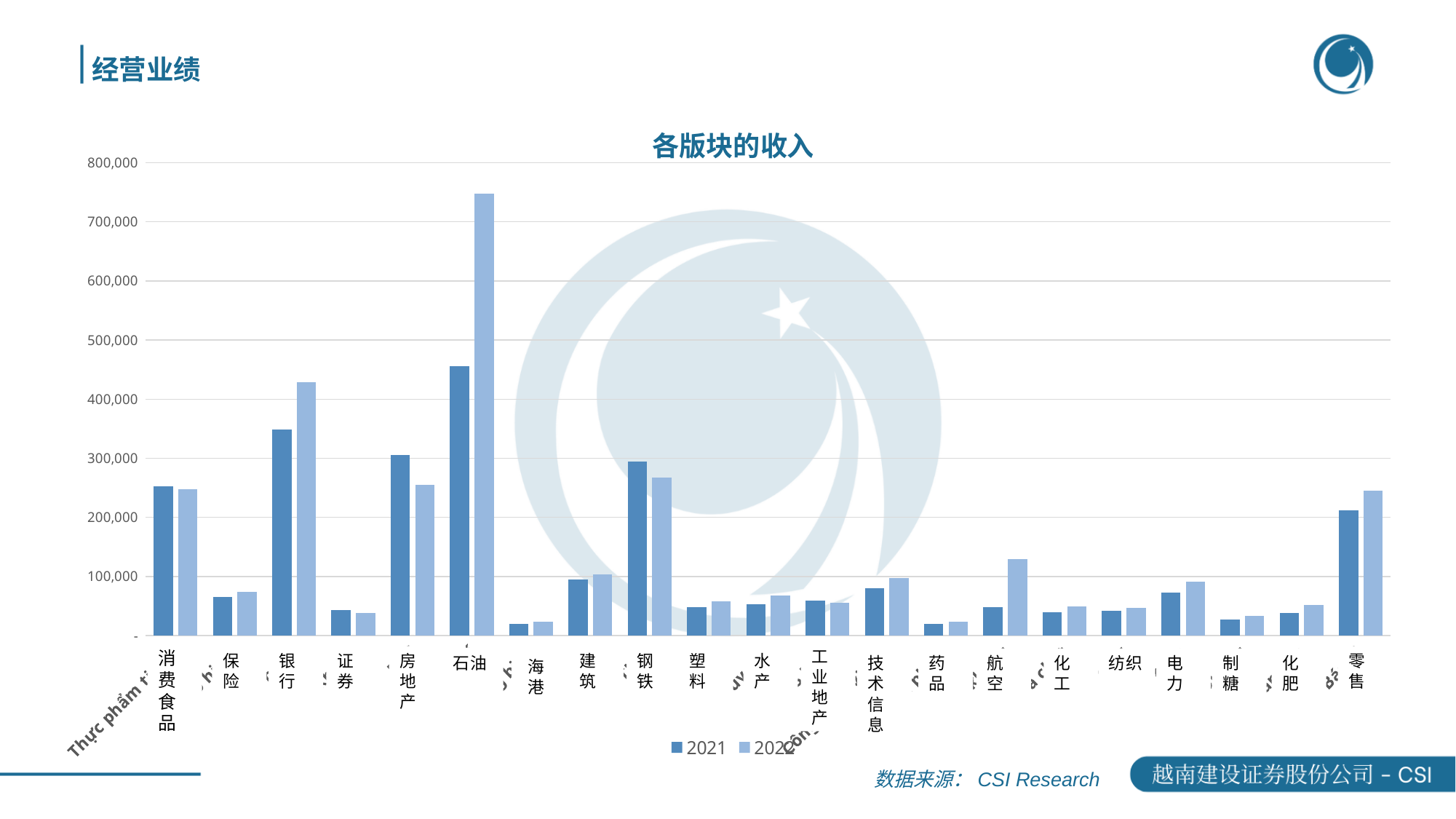
Which sector has the highest bar in the chart? 石油 What is the title of the chart? 各版块的收入 Is the 2021 value for 消费食品 greater or less than 200,000? greater Is the 2021 value for 海港 greater or less than 100,000? less How many series does the chart's legend list? 2 How many sector categories are shown on the x axis of the chart? 21 Which sector has the larger 2021 value, 银行 or 钢铁? 银行 What kind of chart is shown on the slide? bar chart For 房地产, is the 2021 bar larger or smaller than the second-series bar? larger For 石油, which year has the larger value, 2021 or the second series? the second series (2022) Is the 2021 value for 石油 greater or less than 400,000? greater